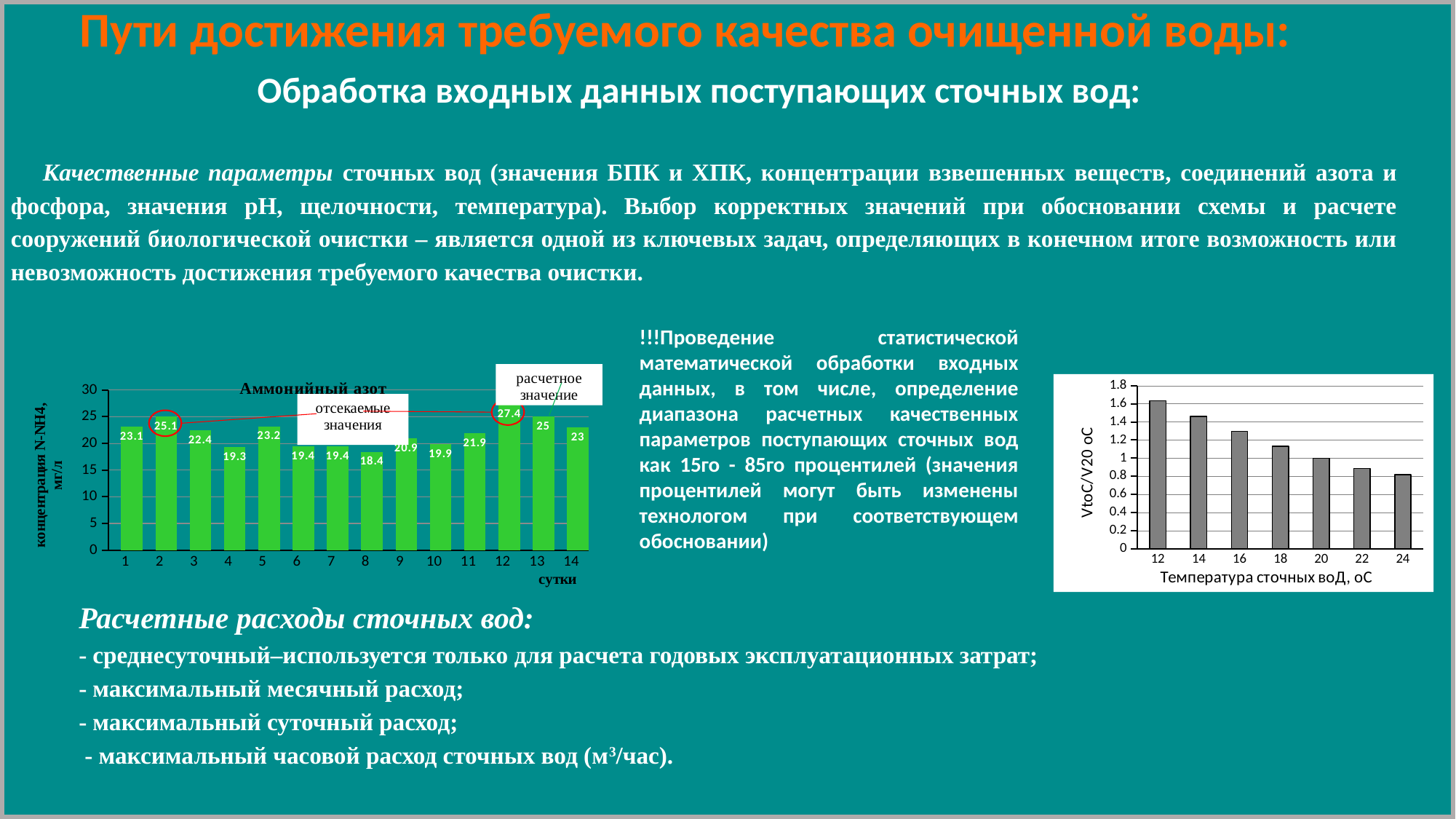
In the 'Аммонийный азот' chart, what is the difference between the values for day 12 and day 8? 9 In the chart on the right (VtoC/V20 vs temperature), do the values rise or fall as temperature increases? fall In the 'Аммонийный азот' chart, which is larger, the value for day 2 or the value for day 13? day 2 In the chart on the right (VtoC/V20 vs temperature), is the value at 12 °C greater or less than 1.4? greater How many days (bars) are shown in the 'Аммонийный азот' chart? 14 In the 'Аммонийный азот' chart, what is the value for day 12? 27.4 What type of chart is the 'Аммонийный азот' chart? bar chart How many temperature categories are shown in the chart on the right? 7 In the chart on the right (VtoC/V20 vs temperature), is the value at 24 °C greater or less than 1? less In the 'Аммонийный азот' chart, which day has the highest concentration? 12 In the 'Аммонийный азот' chart, what is the value for day 8? 18.4 In the 'Аммонийный азот' chart, which day has the lowest concentration? 8